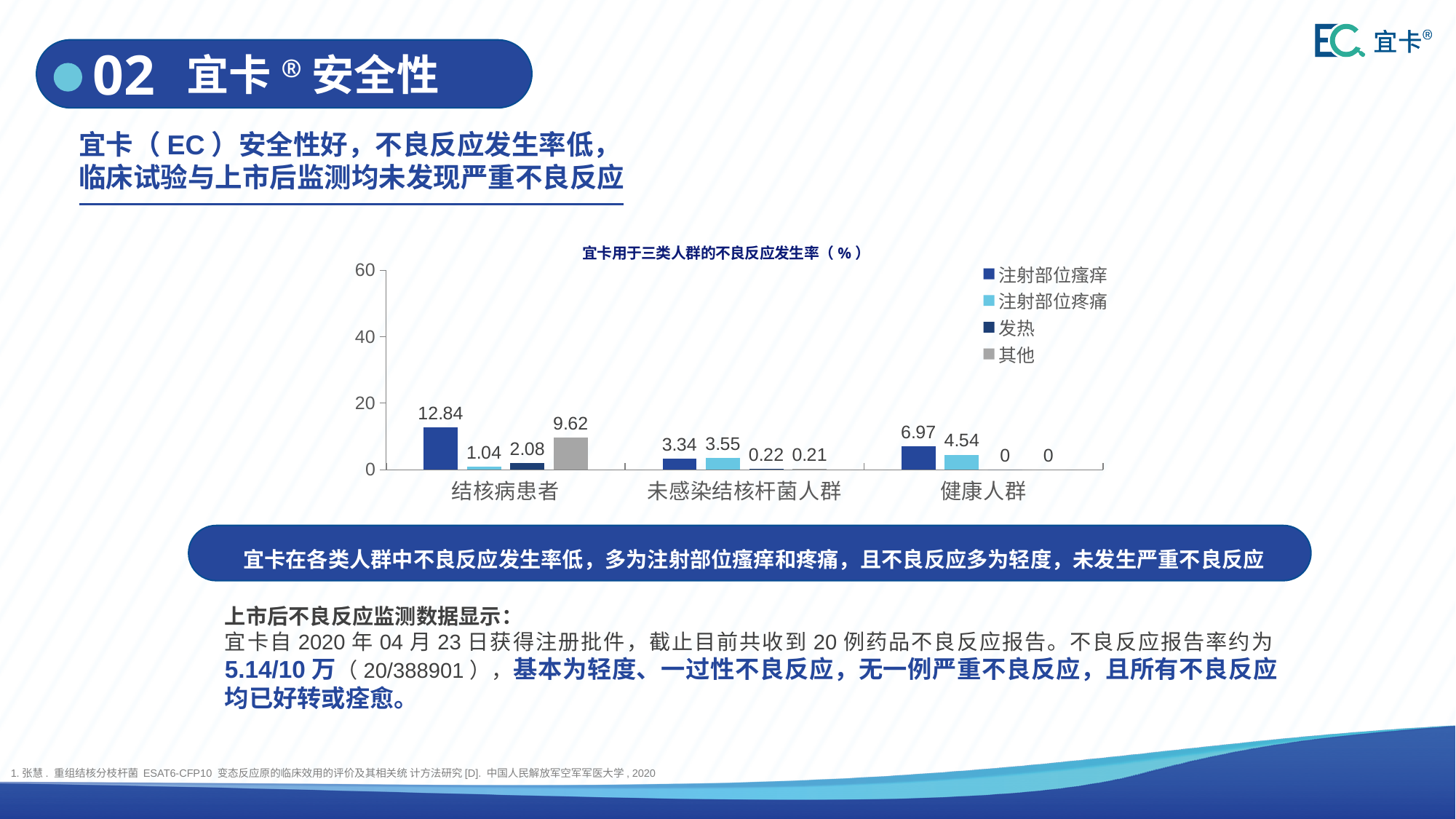
What is the difference between the 注射部位瘙痒 value for 结核病患者 and for 健康人群? 5.87 Is the 注射部位瘙痒 value for 结核病患者 greater or less than 20? less What is the 注射部位瘙痒 value for 结核病患者? 12.84 Which population group has the highest 注射部位瘙痒 value? 结核病患者 Which is larger for 结核病患者: 发热 or 其他? 其他 What is the 其他 value for 结核病患者? 9.62 What kind of chart is shown on the slide? bar chart How many population groups are shown on the x axis? 3 Which population group has the lowest 注射部位疼痛 value? 结核病患者 What is the 发热 value for 健康人群? 0 What is the 注射部位疼痛 value for 未感染结核杆菌人群? 3.55 How many series does the legend list? 4